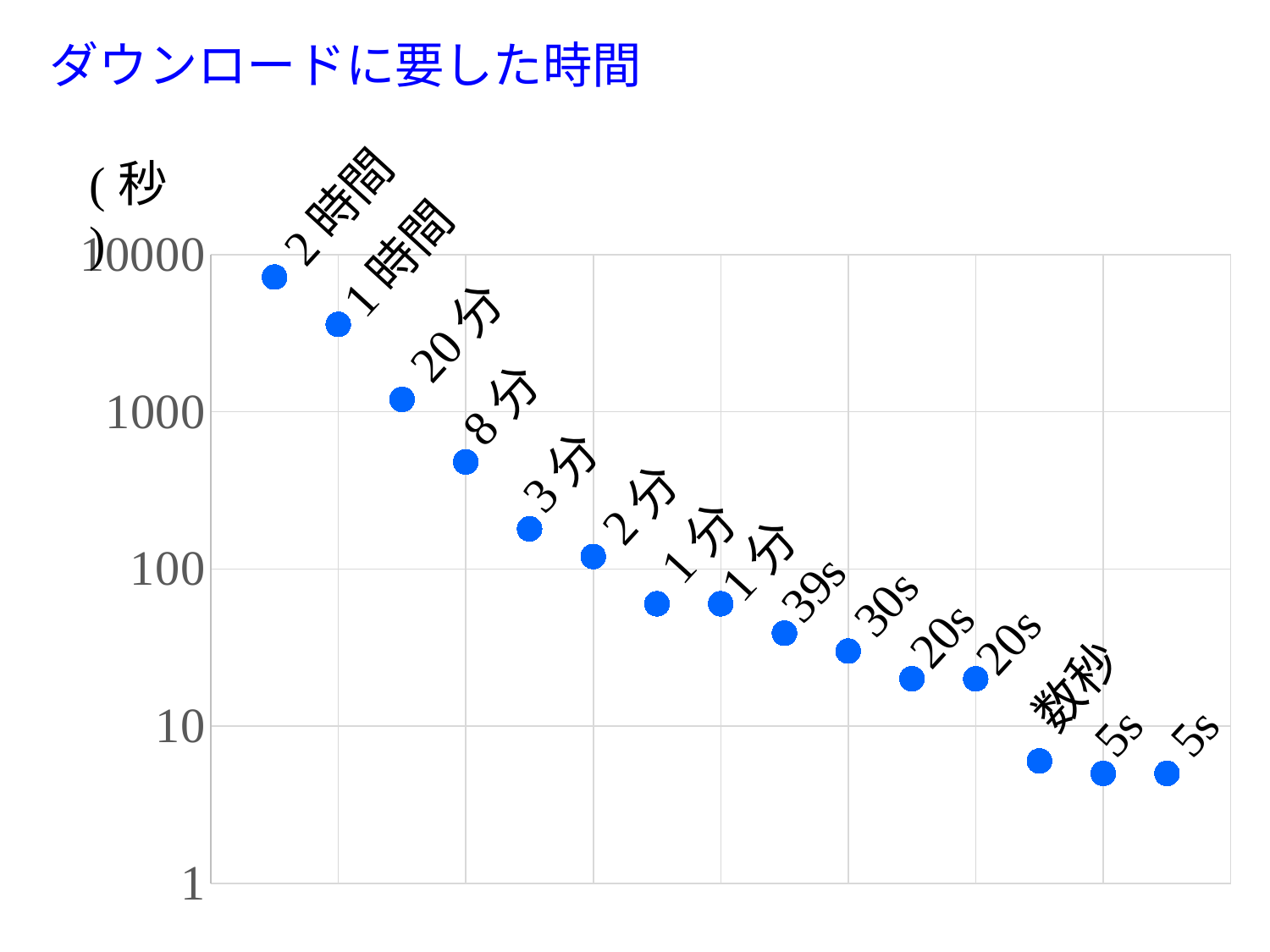
What is the data label on the rightmost point of the chart? 5s How many data points are plotted in the chart? 15 What is the data label on the leftmost point of the chart? 2時間 What kind of chart is shown on the slide? scatter chart Is the value of the point labeled 8分 greater or less than 1000? less Is the value of the point labeled 39s greater or less than 100? less Do the plotted values rise or fall from left to right along the x axis? fall Is the value of the point labeled 3分 greater or less than 100? greater What unit is shown for the y axis of the chart? 秒 What is the title of the chart? ダウンロードに要した時間 Which data label belongs to the highest point in the chart? 2時間